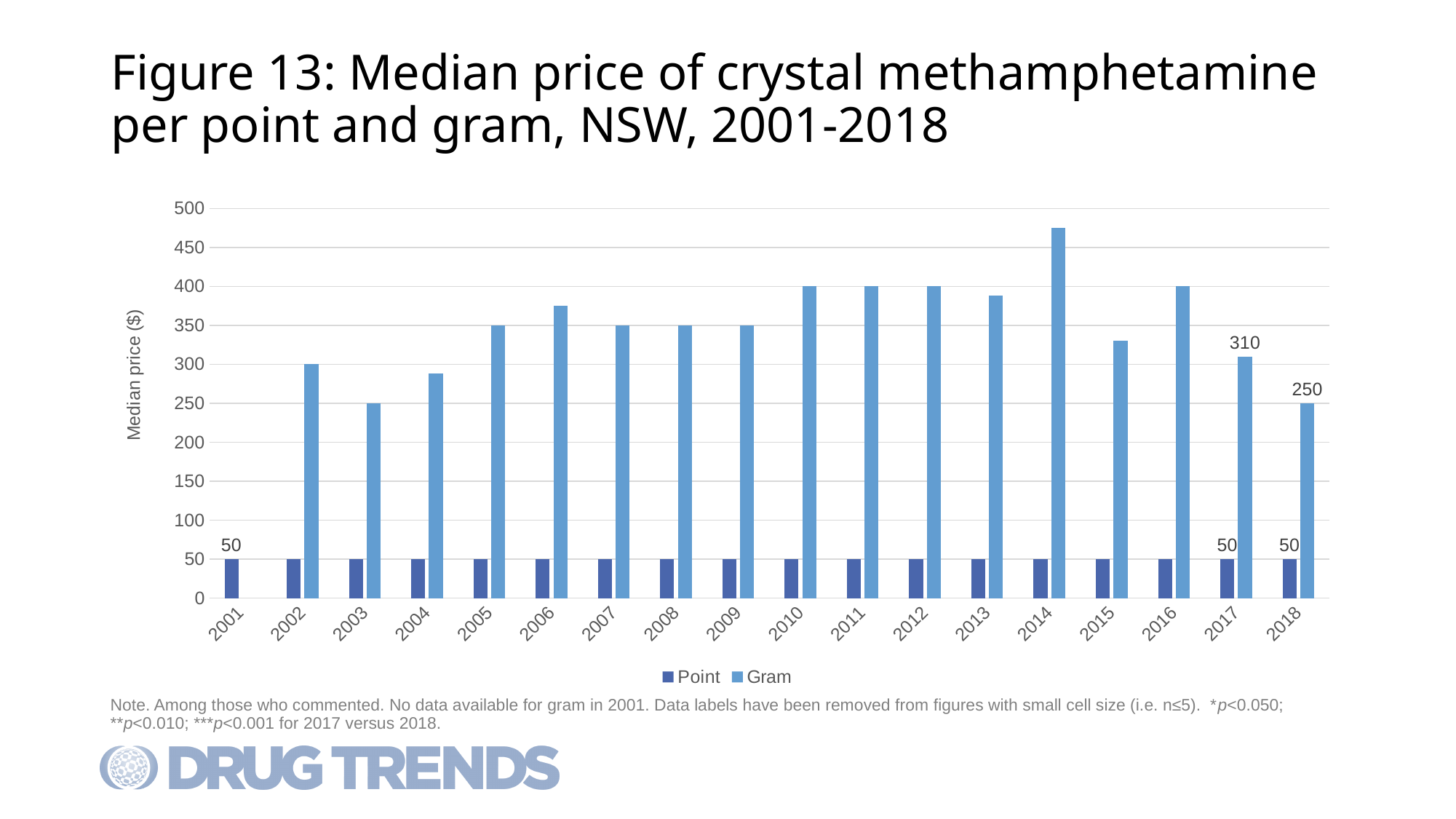
What kind of chart is shown on the slide? bar chart What is the median price per gram in 2018? 250 What is the difference between the median price per gram in 2017 and in 2018? 60 How many years are shown on the x axis? 18 Which is larger, the median price per gram in 2017 or in 2018? 2017 Is the median price per gram in 2014 greater or less than 450? greater Is the median price per gram in 2003 greater or less than 300? less How many series does the legend list? 2 In which year is the median price per gram highest? 2014 What is the median price per gram in 2017? 310 What is the median price per point in 2001? 50 What is the median price per point in 2018? 50